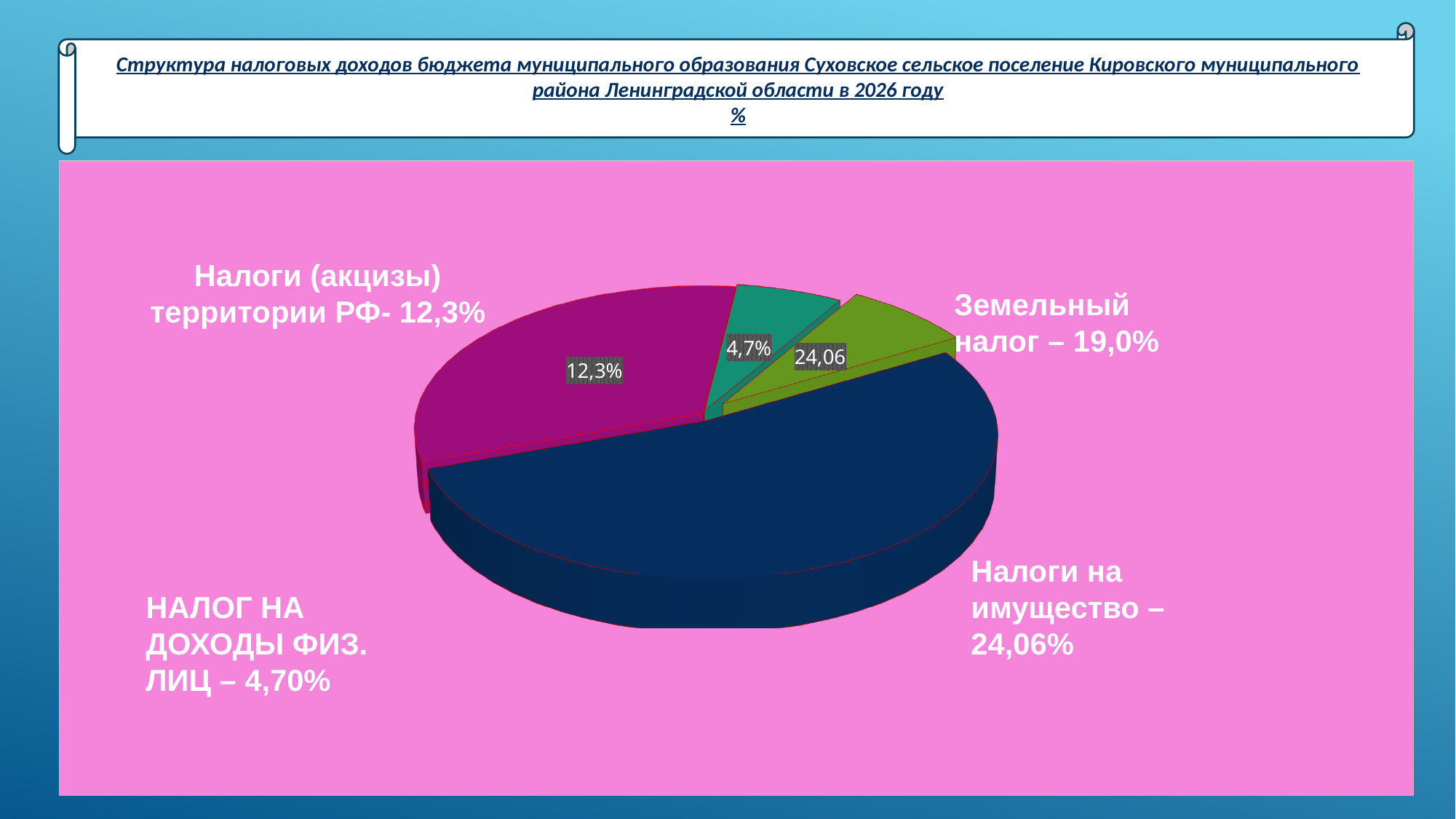
Which of the labelled categories has the lowest percentage? НАЛОГ НА ДОХОДЫ ФИЗ. ЛИЦ Which is larger: the percentage for Земельный налог or for Налоги (акцизы) территории РФ? Земельный налог What percentage is shown for НАЛОГ НА ДОХОДЫ ФИЗ. ЛИЦ? 4,70% Which of the labelled categories has the highest percentage? Налоги на имущество What percentage is shown for Земельный налог on the pie chart? 19,0% What kind of chart is shown on the slide? Pie chart How many slices does the pie chart have? 4 What percentage is shown for Налоги (акцизы) территории РФ? 12,3% What is the difference in percentage points between Налоги на имущество (24,06%) and Земельный налог (19,0%)? 5,06 What colour is the largest slice of the pie chart? Dark blue Which year does the chart title refer to? 2026 What percentage is shown for Налоги на имущество? 24,06%